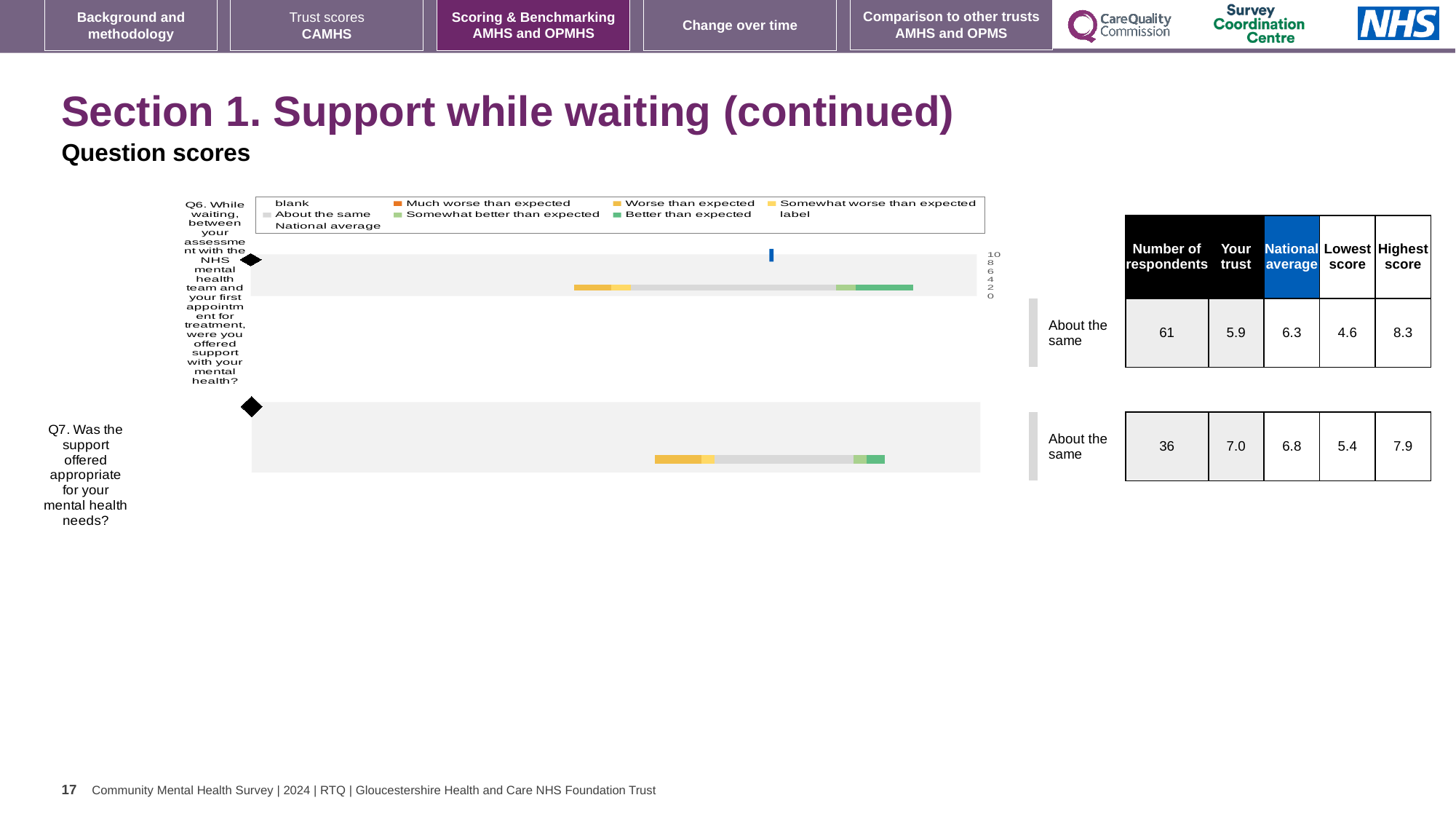
Which question has the higher 'Your trust' score, Q6 or Q7? Q7 For Q6 (support while waiting), what is the lowest score? 4.6 What benchmark category label is shown next to the Q7 bar? About the same For Q7 (was the support offered appropriate), what is the 'Your trust' score? 7.0 For Q6 (support while waiting), what is the 'Your trust' score? 5.9 For Q7, what is the difference between the highest score and the lowest score? 2.5 For Q6 (support while waiting), what is the national average score? 6.3 For Q6 (support while waiting), what is the number of respondents shown? 61 For Q6, how much higher is the national average than the 'Your trust' score? 0.4 For Q7 (was the support offered appropriate), what is the highest score? 7.9 What kind of chart is used to show the Q6 and Q7 question scores? bar chart How many questions (Q6 and Q7) are charted on the slide? 2